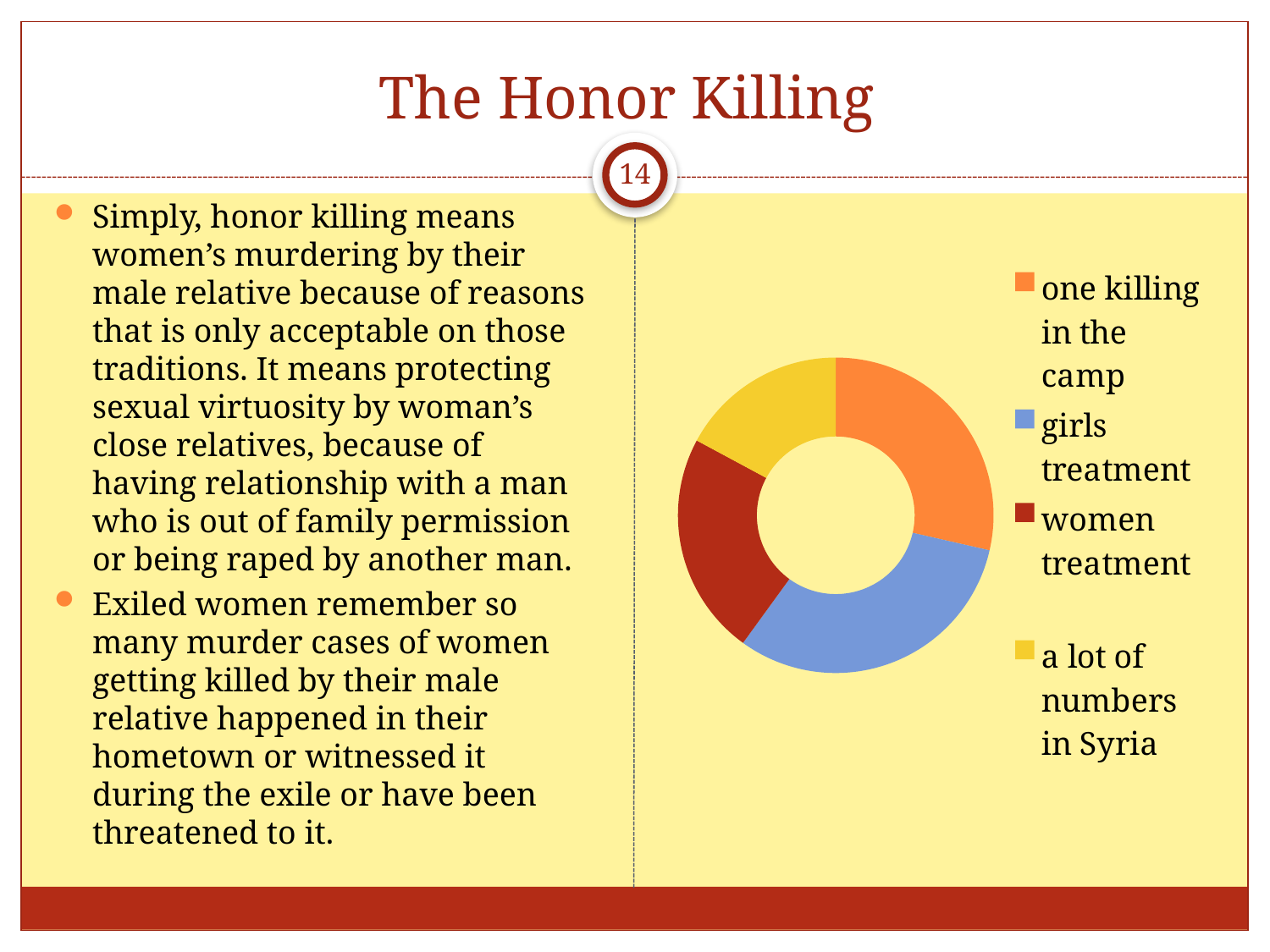
How many categories does the chart show? 4 Which category has the smallest slice in the chart? a lot of numbers in Syria Which category is shown in yellow in the chart? a lot of numbers in Syria Which slice is larger: "one killing in the camp" or "a lot of numbers in Syria"? one killing in the camp What kind of chart is shown on the slide? doughnut chart Which slice is larger: "women treatment" or "a lot of numbers in Syria"? women treatment Which slice is larger: "girls treatment" or "a lot of numbers in Syria"? girls treatment How many entries does the chart's legend list? 4 What colour represents "girls treatment" in the chart? blue